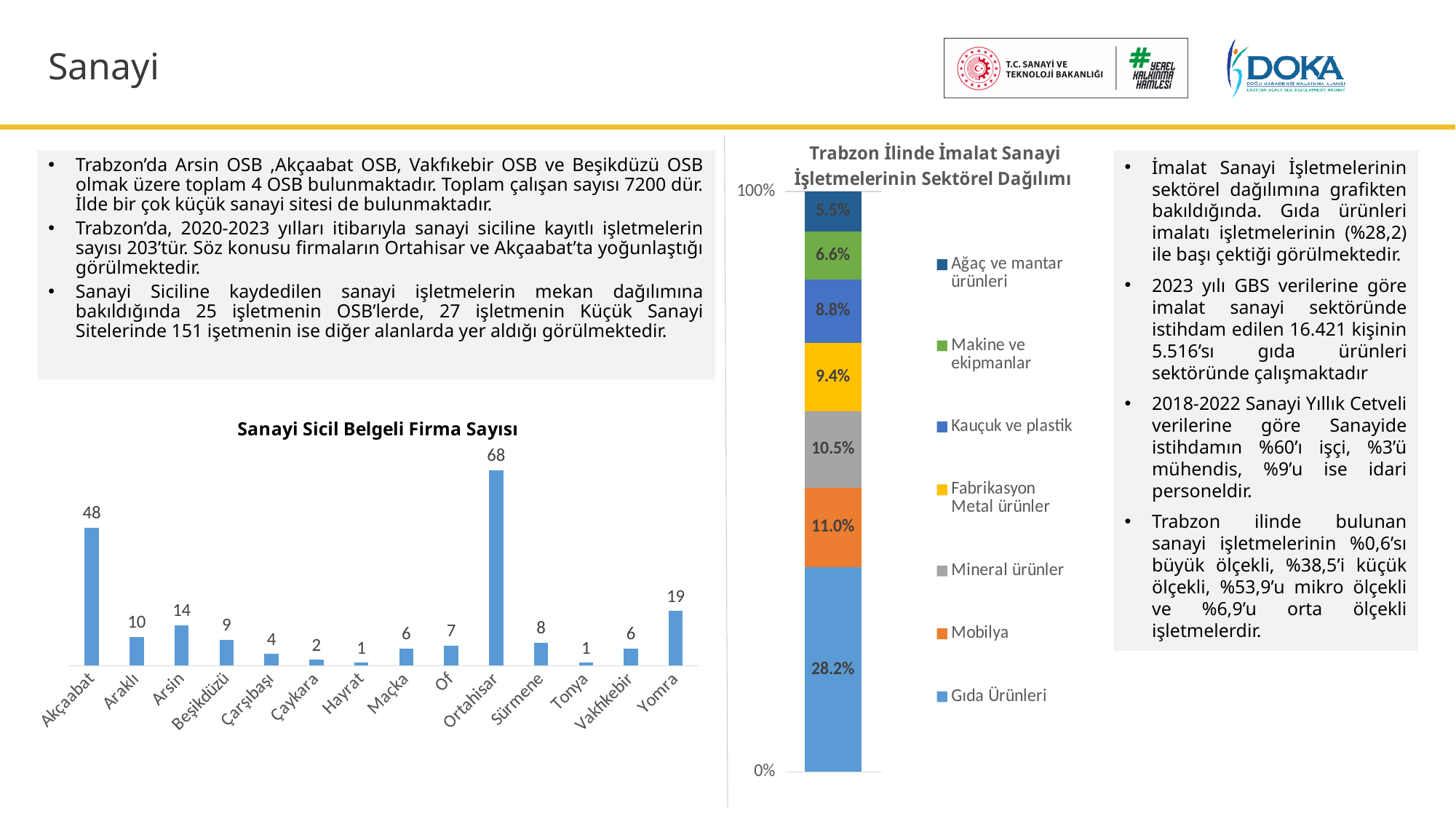
In the 'Trabzon İlinde İmalat Sanayi İşletmelerinin Sektörel Dağılımı' chart, what is the share for Mobilya? 11.0% In the 'Sanayi Sicil Belgeli Firma Sayısı' chart, what is the value for Yomra? 19 In the 'Sanayi Sicil Belgeli Firma Sayısı' chart, what is the difference between Ortahisar and Akçaabat? 20 In the 'Sanayi Sicil Belgeli Firma Sayısı' chart, which is larger, Arsin or Araklı? Arsin In the 'Trabzon İlinde İmalat Sanayi İşletmelerinin Sektörel Dağılımı' chart, which sector has the smallest share? Ağaç ve mantar ürünleri How many districts are shown in the 'Sanayi Sicil Belgeli Firma Sayısı' chart? 14 In the 'Trabzon İlinde İmalat Sanayi İşletmelerinin Sektörel Dağılımı' chart, what is the difference between Mineral ürünler and Kauçuk ve plastik? 1.7% What type of chart is 'Sanayi Sicil Belgeli Firma Sayısı'? Bar chart How many sectors does the legend of the 'Trabzon İlinde İmalat Sanayi İşletmelerinin Sektörel Dağılımı' chart list? 7 In the 'Trabzon İlinde İmalat Sanayi İşletmelerinin Sektörel Dağılımı' chart, what is the share for Gıda Ürünleri? 28.2% In the 'Sanayi Sicil Belgeli Firma Sayısı' chart, which district has the highest value? Ortahisar In the 'Sanayi Sicil Belgeli Firma Sayısı' chart, what is the value for Ortahisar? 68